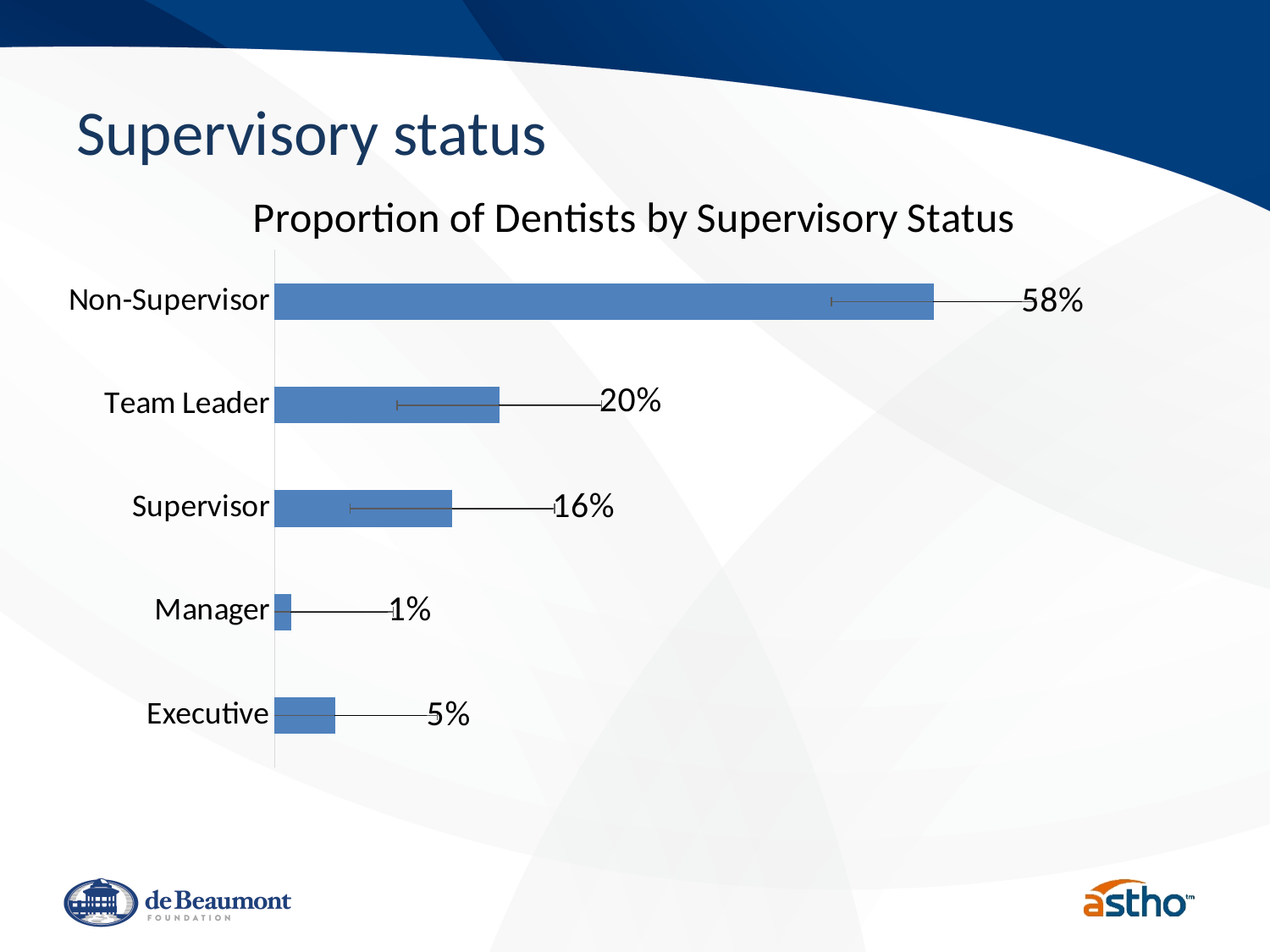
What is the value for Non-Supervisor? 58% What kind of chart is shown on the slide? Bar chart What is the difference between the values for Team Leader and Supervisor? 4% What is the value for Supervisor? 16% What is the value for Executive? 5% Which category has the highest value? Non-Supervisor How many categories are shown in the chart? 5 What is the difference between the values for Non-Supervisor and Team Leader? 38% Which category has the lowest value? Manager Which is larger, the value for Executive or the value for Manager? Executive What is the value for Team Leader? 20% What is the value for Manager? 1%